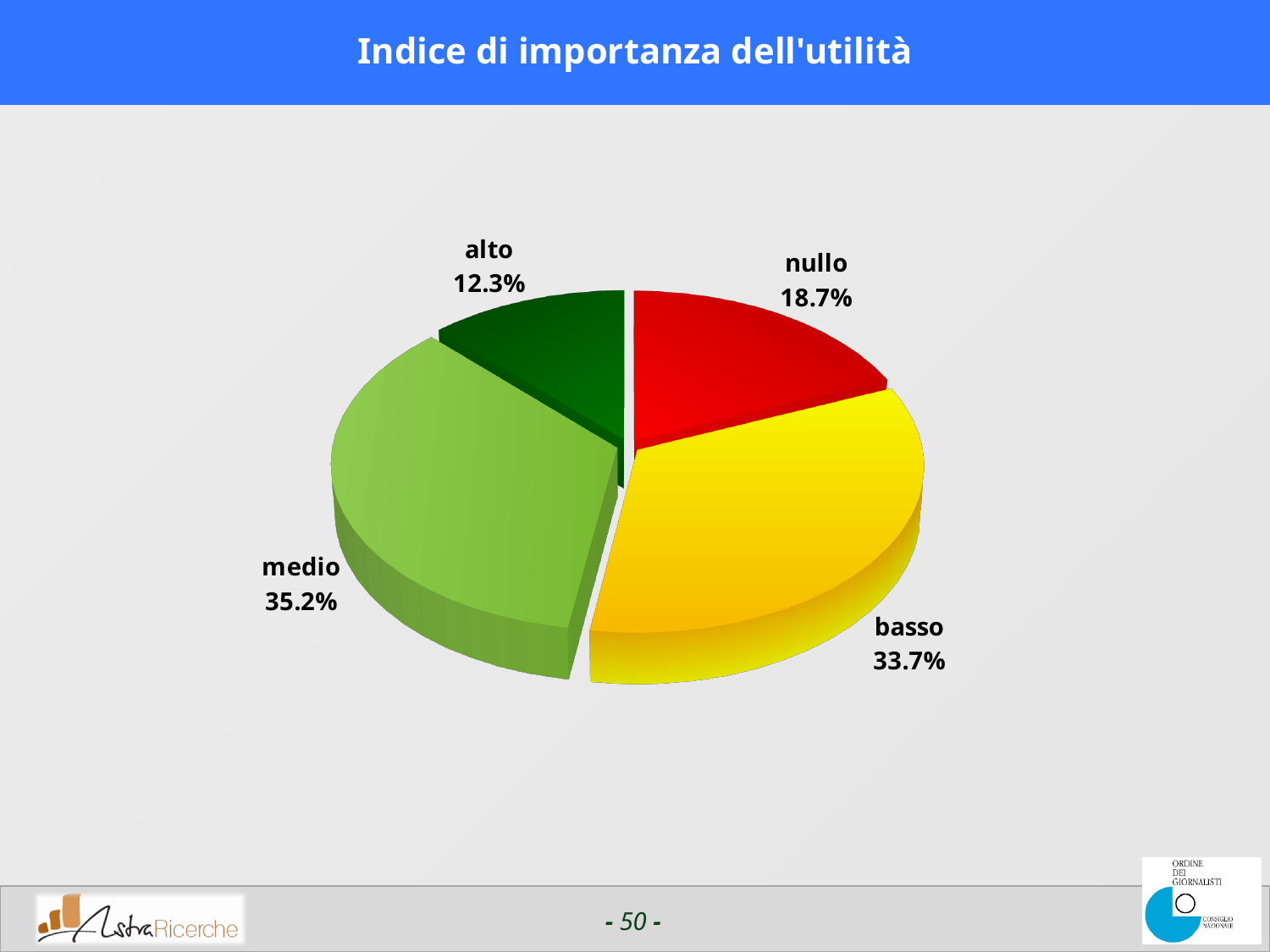
Which category has the smallest slice of the pie? alto What kind of chart is shown on the slide? pie chart How many slices does the pie chart have? 4 What is the value shown for 'nullo'? 18.7% Which is larger, the 'nullo' slice or the 'alto' slice? nullo What is the difference in percentage points between 'medio' and 'basso'? 1.5 What is the difference in percentage points between 'nullo' and 'alto'? 6.4 What percentage is labelled for 'basso'? 33.7% Which category has the largest slice of the pie? medio What is the title of the chart? Indice di importanza dell'utilità What share of the pie does the 'medio' slice represent? 35.2% What is the value for 'alto'? 12.3%